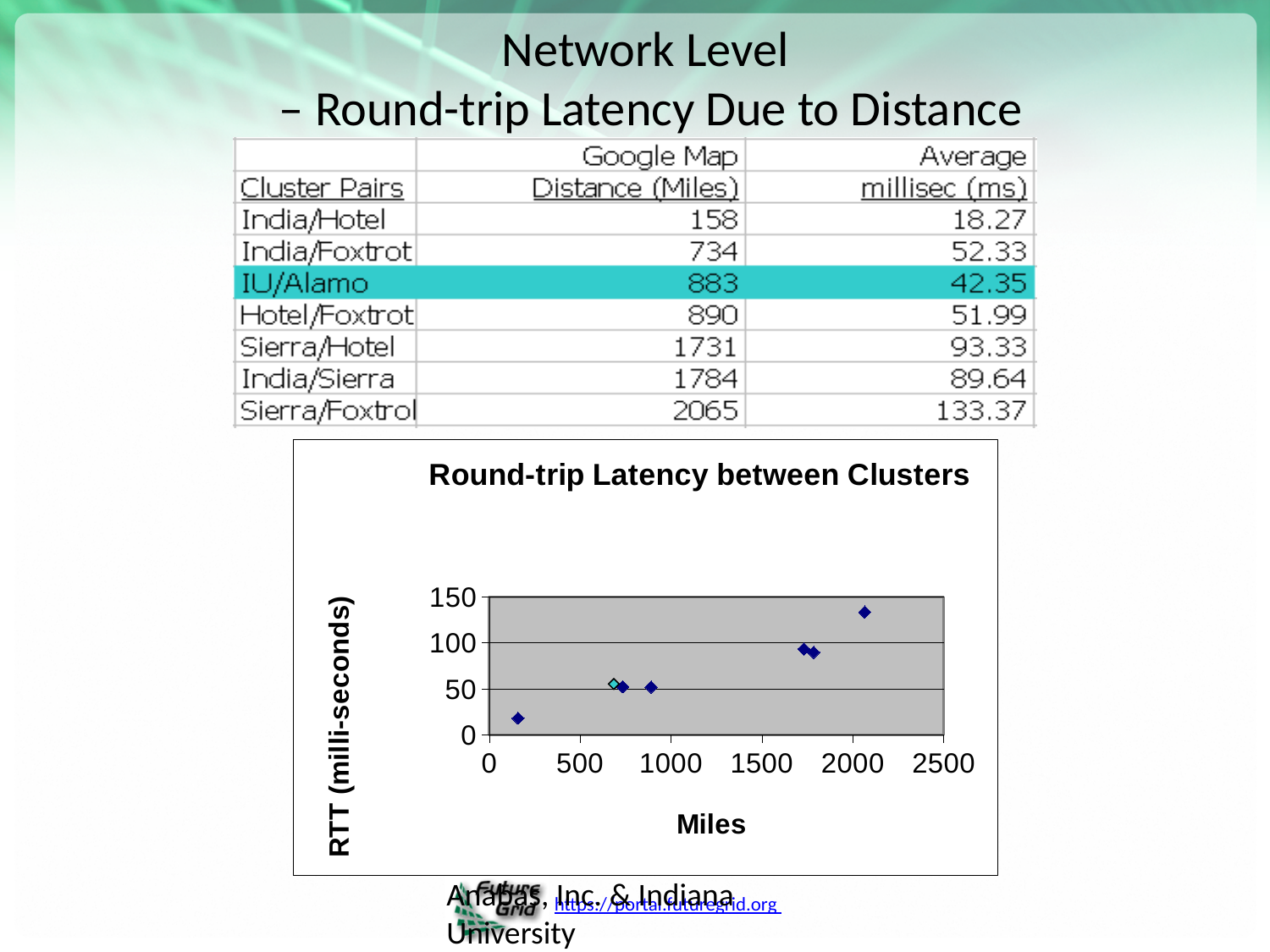
What is the label of the y axis of the chart? RTT (milli-seconds) Which has the larger average latency, Sierra/Hotel or India/Sierra? Sierra/Hotel Is the RTT value for the point nearest 0 miles greater or less than 50? less Is the RTT value for the point at about 2000 miles greater or less than 100? greater What is the average round-trip latency in milliseconds for the IU/Alamo cluster pair? 42.35 Do the RTT values generally rise or fall as Miles increases along the x axis? rise Which cluster pair has the highest average round-trip latency? Sierra/Foxtrol What kind of chart is shown on the slide? scatter chart What is the title of the chart? Round-trip Latency between Clusters Is the RTT value for the points near 1750 miles greater or less than 50? greater Which cluster pair has the lowest average round-trip latency? India/Hotel